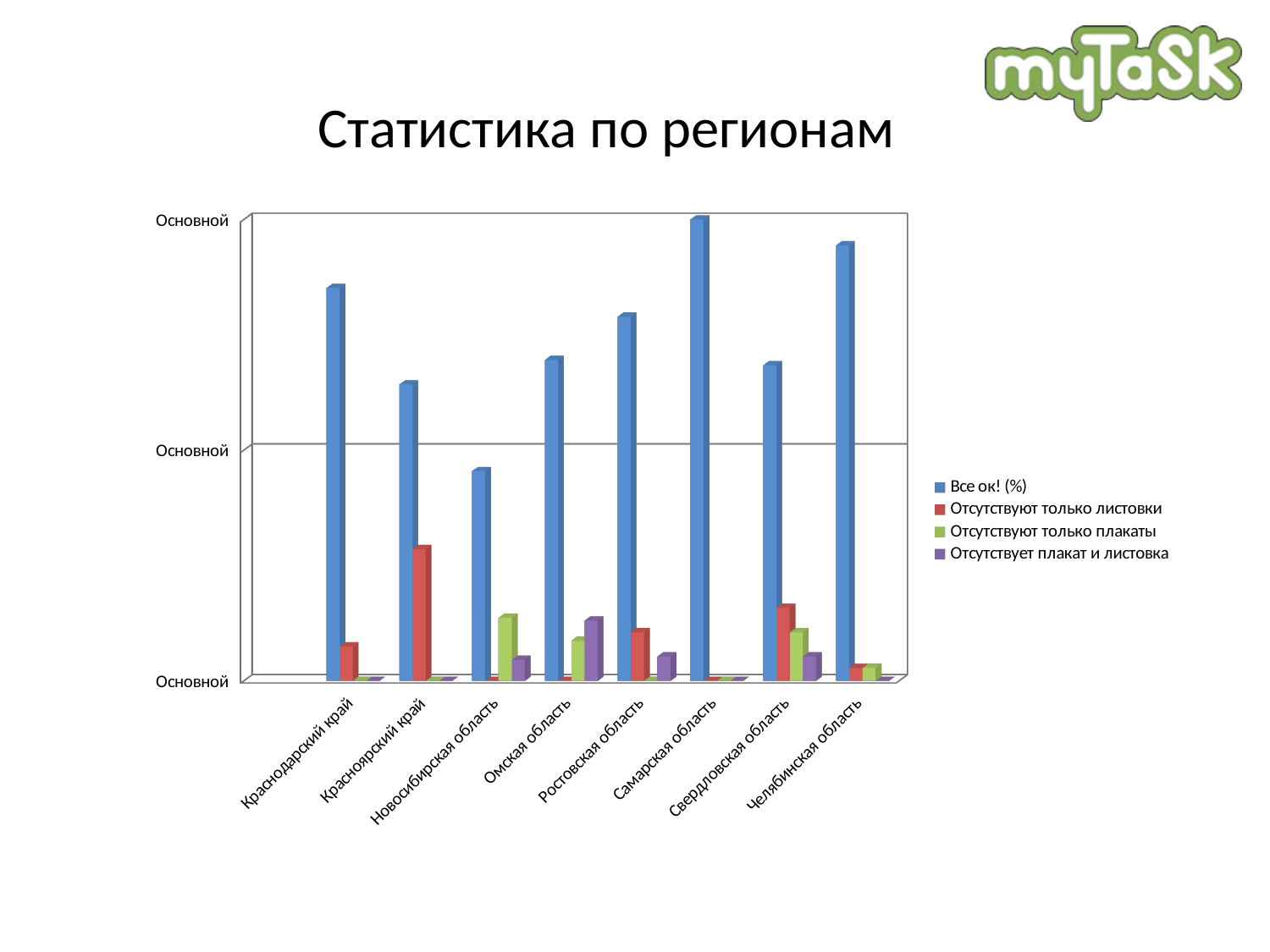
How many regions (categories) are shown on the x axis of the chart? 8 What kind of chart is shown on the slide? bar chart For the series "Все ок! (%)", which is larger: Краснодарский край or Красноярский край? Краснодарский край How many series does the chart legend list? 4 Which region has the highest value for the series "Отсутствуют только плакаты"? Новосибирская область Which region has the highest value for the series "Все ок! (%)"? Самарская область Which legend entry is shown in blue? Все ок! (%) What is the title of the chart on the slide? Статистика по регионам Which region has the highest value for the series "Отсутствуют только листовки"? Красноярский край For the series "Все ок! (%)", which is larger: Свердловская область or Челябинская область? Челябинская область Which region has the lowest value for the series "Все ок! (%)"? Новосибирская область